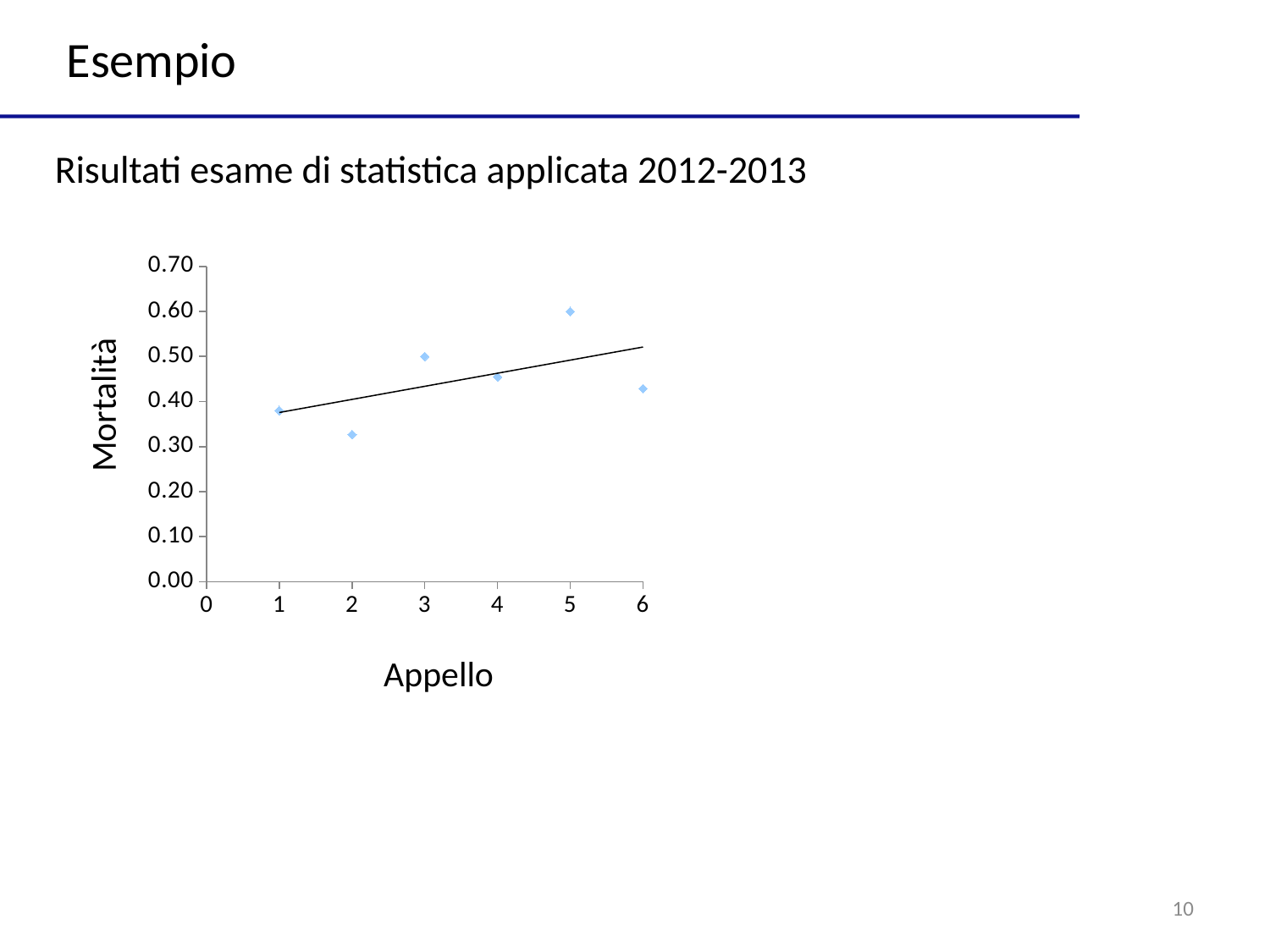
Which appello has the lowest mortalità? 2 Which has a higher mortalità, appello 3 or appello 2? appello 3 Which appello has the highest mortalità? 5 What kind of chart is shown on the slide? scatter chart What is the label of the vertical axis? Mortalità Does the fitted trend line rise or fall as the appello number increases? rise Is the mortalità for appello 6 greater or less than 0.40? greater How many data points are plotted in the chart? 6 Is the mortalità for appello 2 greater or less than 0.30? greater What is the mortalità value for appello 5? 0.60 Is the mortalità for appello 4 greater or less than 0.50? less